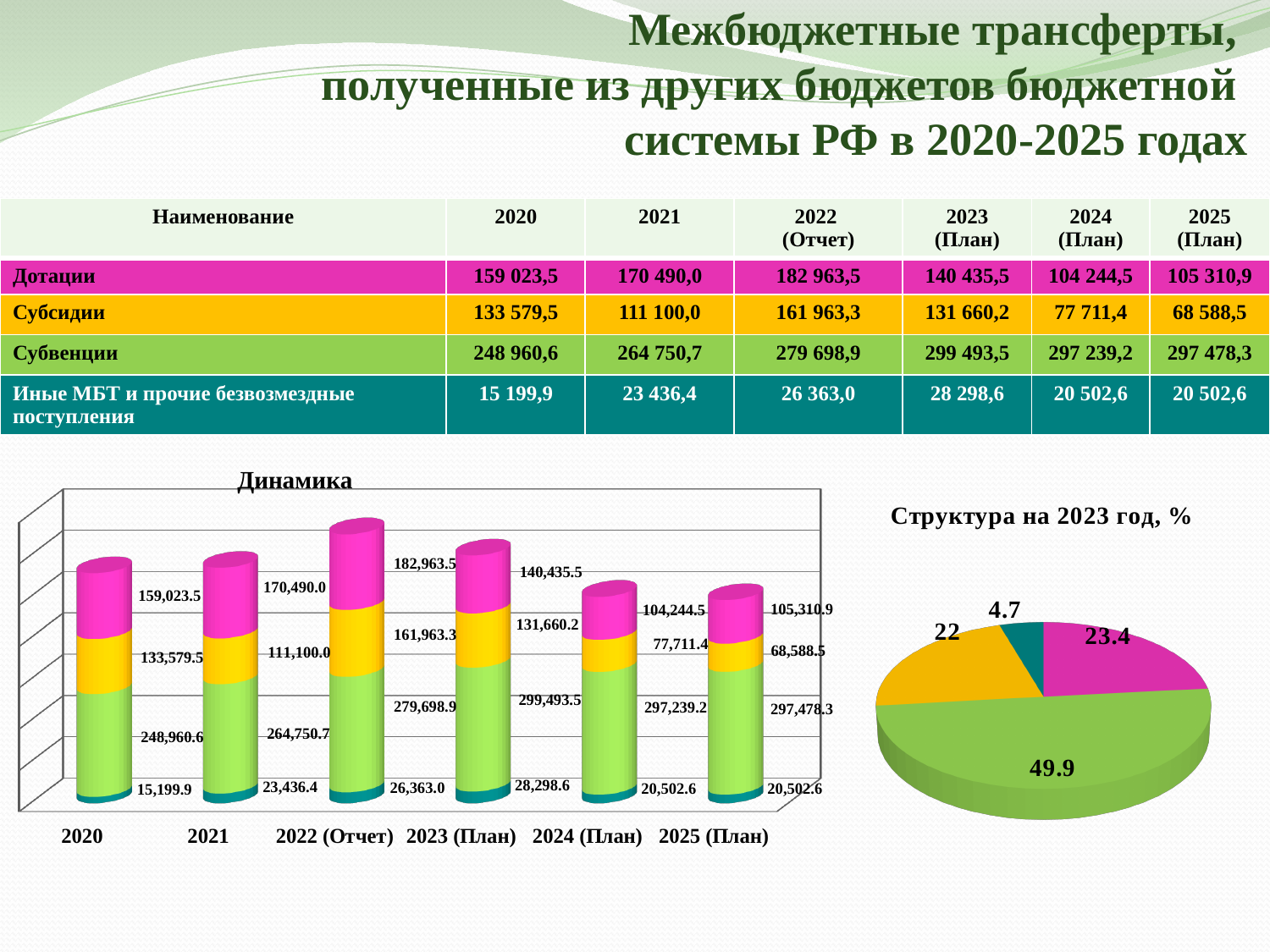
In the "Динамика" chart, which year has the larger yellow segment, 2021 or 2022 (Отчет)? 2022 (Отчет) In the "Динамика" chart, how many years (categories) are shown on the x axis? 6 In the "Структура на 2023 год, %" chart, which slice is the largest? 49.9 In the "Структура на 2023 год, %" chart, how many slices does the pie have? 4 In the "Структура на 2023 год, %" chart, what is the value of the smallest slice? 4.7 In the "Динамика" chart, what is the difference between the pink segment values for 2022 (Отчет) and 2023 (План)? 42,528.0 In the "Динамика" chart, what is the value of the pink (top) segment for 2020? 159,023.5 What kind of chart is the "Динамика" chart? bar chart In the "Динамика" chart, what is the value of the green segment for 2023 (План)? 299,493.5 In the "Динамика" chart, do the values of the teal (bottom) segment rise or fall from 2020 to 2023 (План)? rise In the "Динамика" chart, what is the total of the stacked bar for 2020? 556,763.5 What kind of chart is the "Структура на 2023 год, %" chart? pie chart